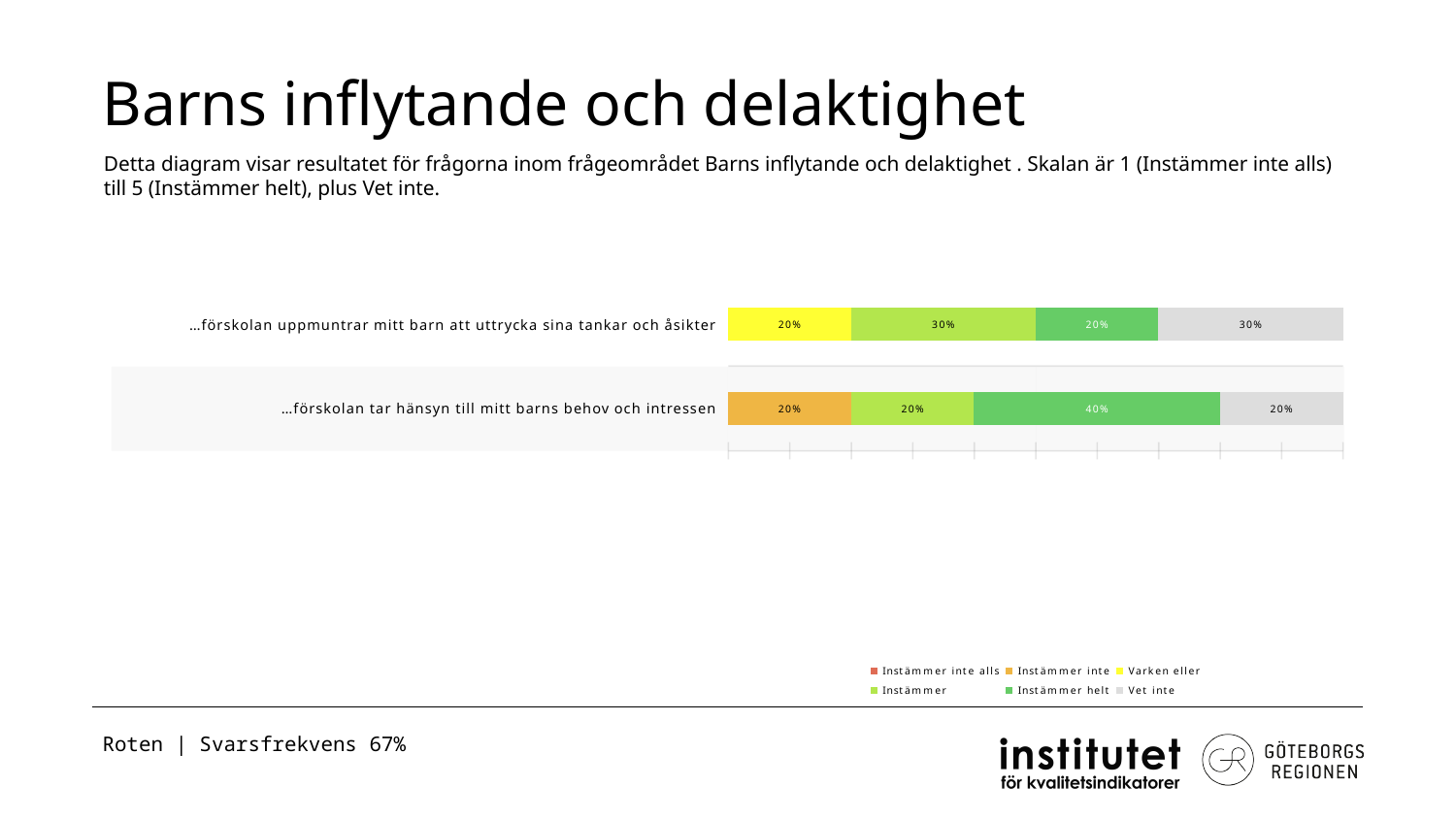
What is the total of the stacked bar for '…förskolan uppmuntrar mitt barn att uttrycka sina tankar och åsikter'? 100% How many series does the legend list? 6 How many categories (questions) are plotted in the chart? 2 What is the difference between the 'Instämmer helt' values of the two categories? 20% What is the 'Instämmer inte' value for '…förskolan tar hänsyn till mitt barns behov och intressen'? 20% What kind of chart is shown on the slide? Stacked bar chart Which category has the larger 'Instämmer helt' share: '…förskolan uppmuntrar mitt barn att uttrycka sina tankar och åsikter' or '…förskolan tar hänsyn till mitt barns behov och intressen'? …förskolan tar hänsyn till mitt barns behov och intressen What is the 'Vet inte' value for '…förskolan uppmuntrar mitt barn att uttrycka sina tankar och åsikter'? 30% What is the 'Instämmer' value for '…förskolan uppmuntrar mitt barn att uttrycka sina tankar och åsikter'? 30% What is the title of the slide containing the chart? Barns inflytande och delaktighet Which segment is the largest in the bar for '…förskolan tar hänsyn till mitt barns behov och intressen'? Instämmer helt What is the 'Instämmer helt' value for '…förskolan tar hänsyn till mitt barns behov och intressen'? 40%